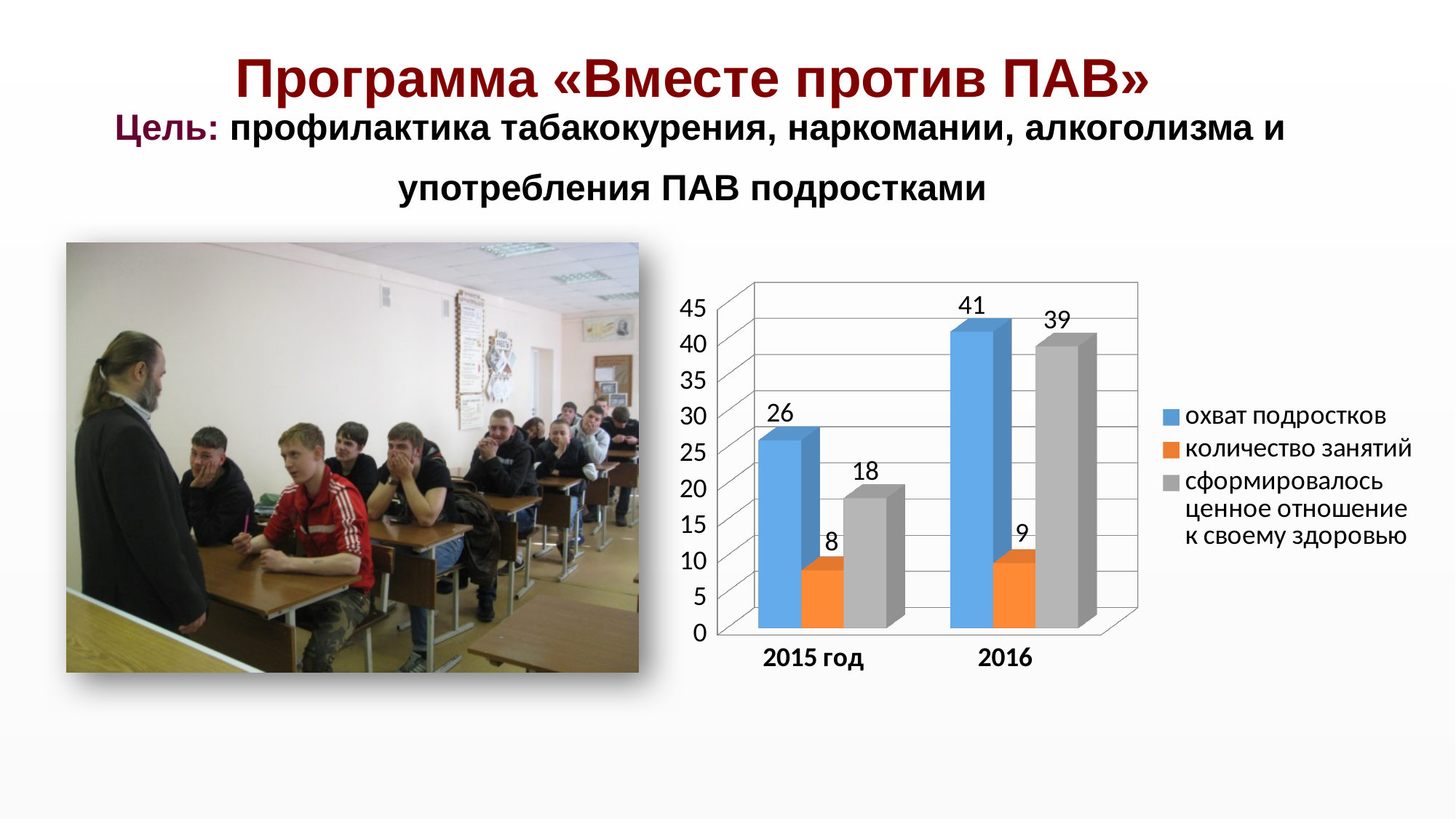
How many categories are shown on the x axis? 2 What is the difference between «охват подростков» in 2016 and in 2015 год? 15 Which is larger: «охват подростков» in 2016 or «сформировалось ценное отношение к своему здоровью» in 2016? охват подростков in 2016 What is the value for «сформировалось ценное отношение к своему здоровью» in 2015 год? 18 Which series has the lowest value in 2016? количество занятий What kind of chart is shown on the slide? bar chart What is the difference between «сформировалось ценное отношение к своему здоровью» in 2016 and in 2015 год? 21 What is the value for «охват подростков» in 2016? 41 How many series does the legend list? 3 What is the value for «количество занятий» in 2016? 9 Which series has the highest value in 2015 год? охват подростков What is the value for «охват подростков» in 2015 год? 26